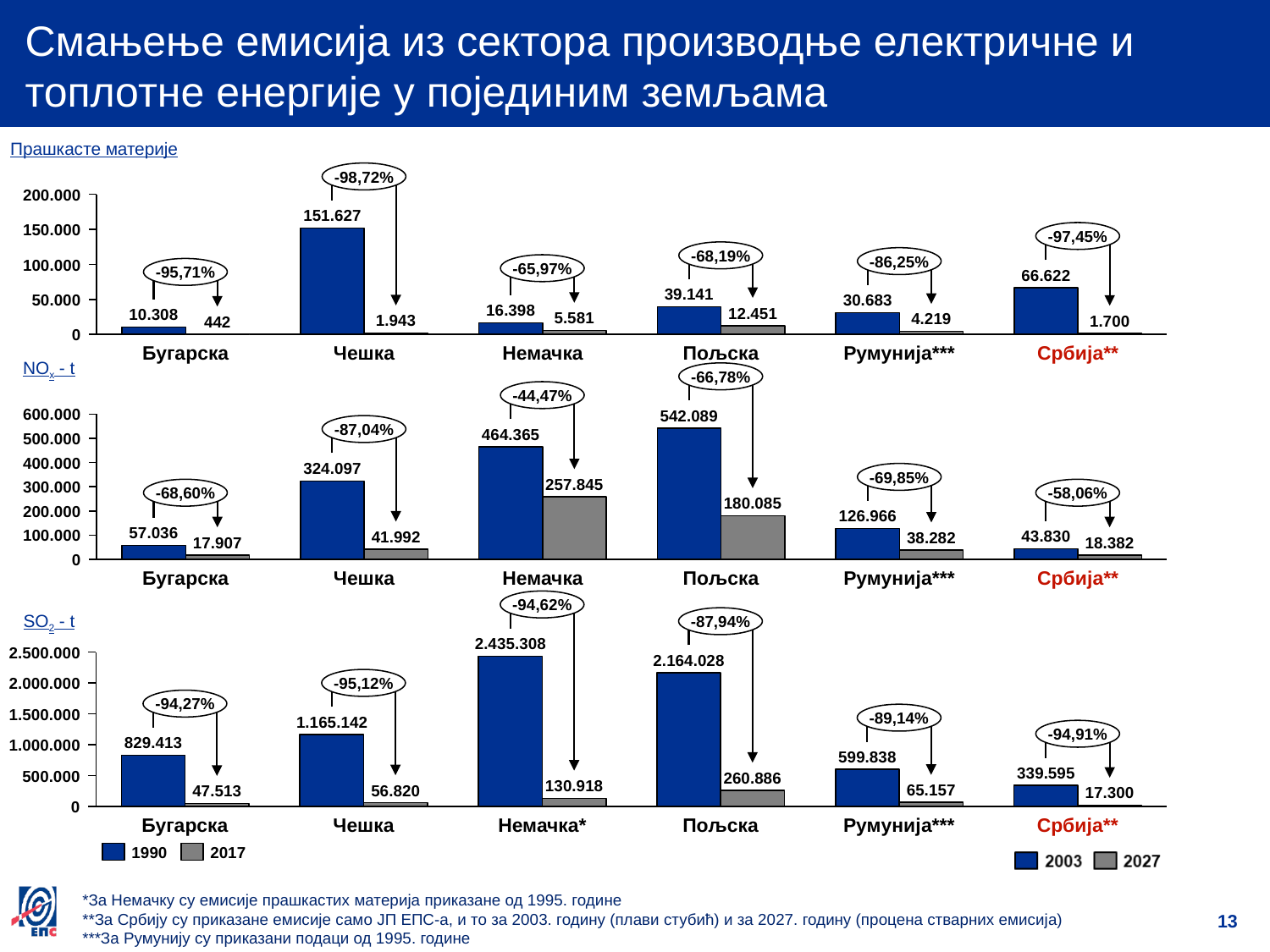
In the Прашкасте материје chart, what is the 2017 value for Бугарска? 442 In the SO2 - t chart, which is larger, the 2017 value for Пољска or the 2017 value for Немачка*? Пољска In the SO2 - t chart, what percentage reduction is shown for Србија**? -94,91% What type of chart is used for the Прашкасте материје data? bar chart In the Прашкасте материје chart, what is the 1990 value for Чешка? 151.627 In the SO2 - t chart, what is the 1990 value for Немачка*? 2.435.308 In the NOx - t chart, what is the 1990 value for Пољска? 542.089 In the SO2 - t chart, is the 1990 value for Румунија*** greater or less than 500.000? greater In the NOx - t chart, which country has the lowest 2017 value? Бугарска In the NOx - t chart, what is the difference between the 1990 and 2017 values for Немачка? 206.520 In the Прашкасте материје chart, which country has the highest 1990 value? Чешка How many countries are shown on the x axis of the NOx - t chart? 6